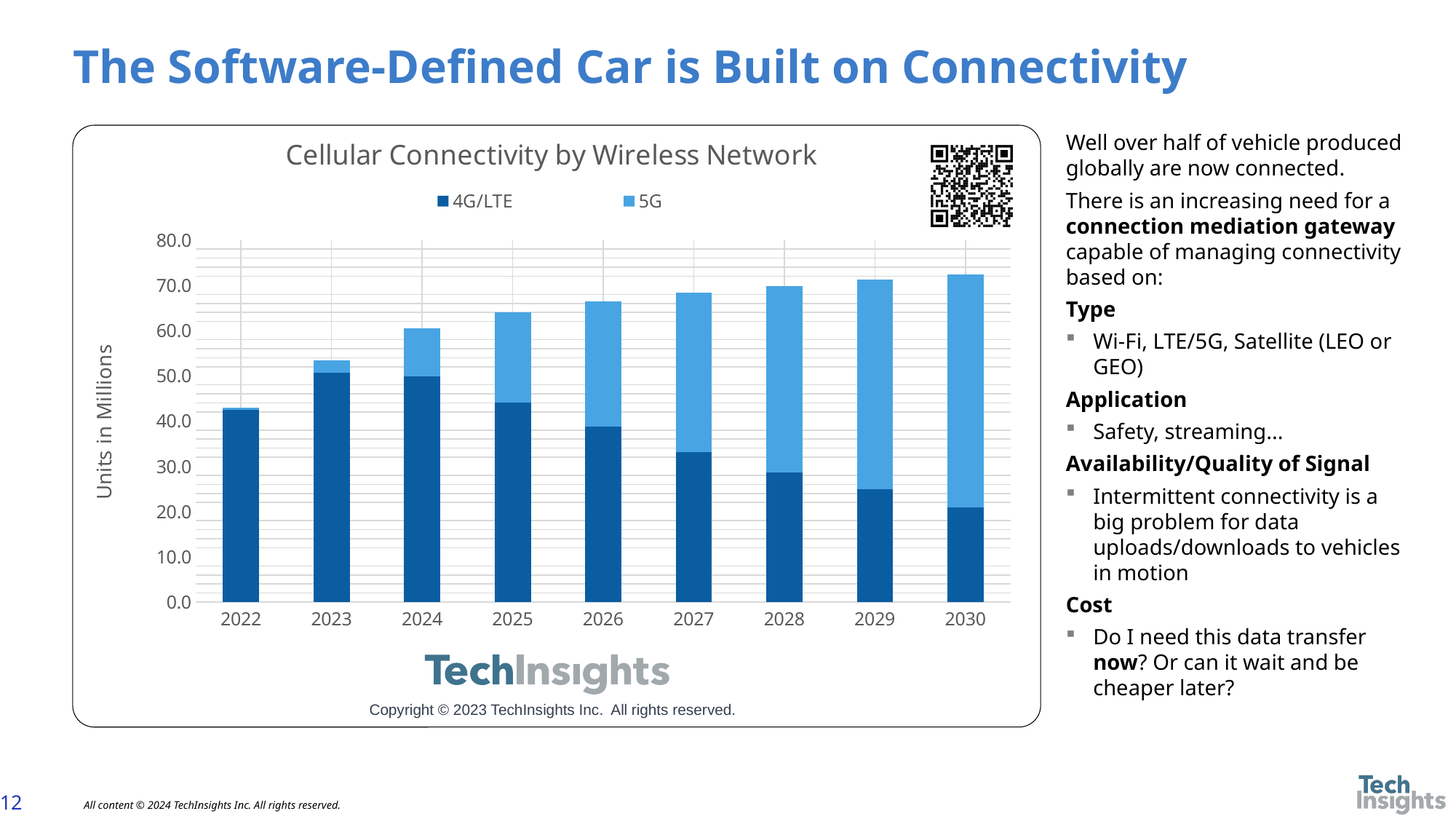
How many years are shown on the x axis of the chart? 9 What is the title of the chart? Cellular Connectivity by Wireless Network Is the 4G/LTE value for 2030 greater or less than 30.0? less Which year has the lowest 4G/LTE value? 2030 Which year has the lowest total stacked bar? 2022 Is the total height of the stacked bar for 2030 greater or less than 70.0? greater What is the label on the y axis of the chart? Units in Millions Does the 4G/LTE segment rise or fall from 2023 to 2030? Fall Is the 4G/LTE value for 2022 greater or less than 40.0? greater How many series does the chart's legend list? 2 What type of chart is shown on the slide? Stacked bar chart